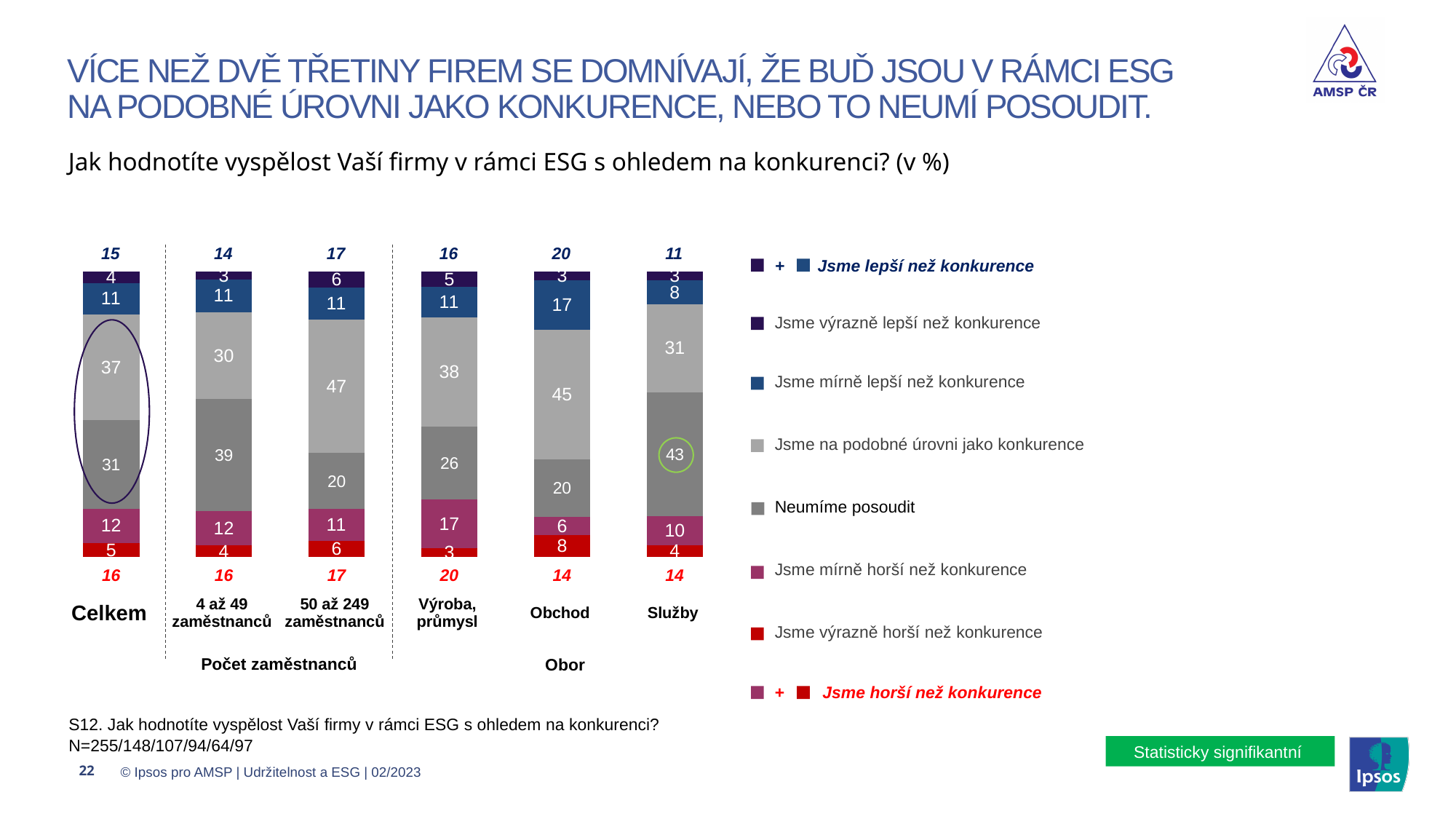
What is the value for "Jsme mírně horší než konkurence" in the Výroba, průmysl bar? 17 What is the value for "Neumíme posoudit" in the Služby bar? 43 How many individual response series (excluding the combined "+" rows) does the legend list? 6 Which is larger: the "Jsme výrazně horší než konkurence" value for Obchod or for Výroba, průmysl? Obchod Which category has the lowest value for "Jsme mírně lepší než konkurence"? Služby What is the value for "Jsme na podobné úrovni jako konkurence" in the Celkem bar? 37 What is the combined "Jsme lepší než konkurence" value shown above the Obchod bar? 20 What kind of chart is shown on the slide? Stacked bar chart What is the value for "Jsme mírně lepší než konkurence" in the Obchod bar? 17 How many categories (bars) are shown in the chart? 6 Which category has the highest value for "Jsme na podobné úrovni jako konkurence"? 50 až 249 zaměstnanců What is the difference between the "Neumíme posoudit" values for 4 až 49 zaměstnanců and 50 až 249 zaměstnanců? 19